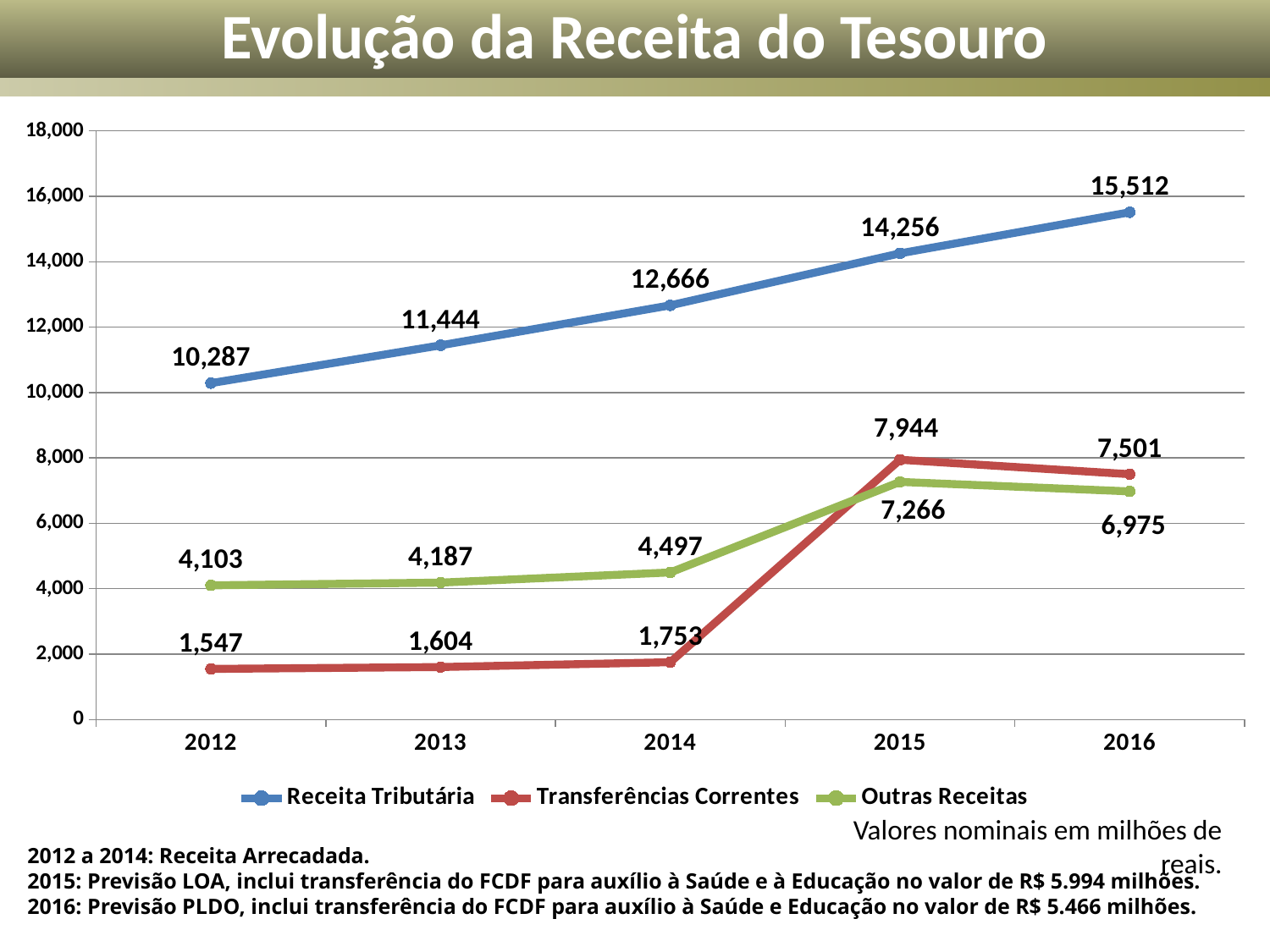
How many years are shown on the x axis? 5 What is the difference between Receita Tributária in 2016 and in 2015? 1,256 What is the value of Outras Receitas in 2012? 4,103 How many series does the legend list? 3 What is the title of the chart? Evolução da Receita do Tesouro Which is larger in 2016, Transferências Correntes or Outras Receitas? Transferências Correntes What type of chart is shown on the slide? line chart In which year is Receita Tributária highest? 2016 What is the value of Transferências Correntes in 2015? 7,944 In which year is Transferências Correntes lowest? 2012 What is the value of Receita Tributária in 2014? 12,666 Does Receita Tributária rise or fall from 2012 to 2016? rise